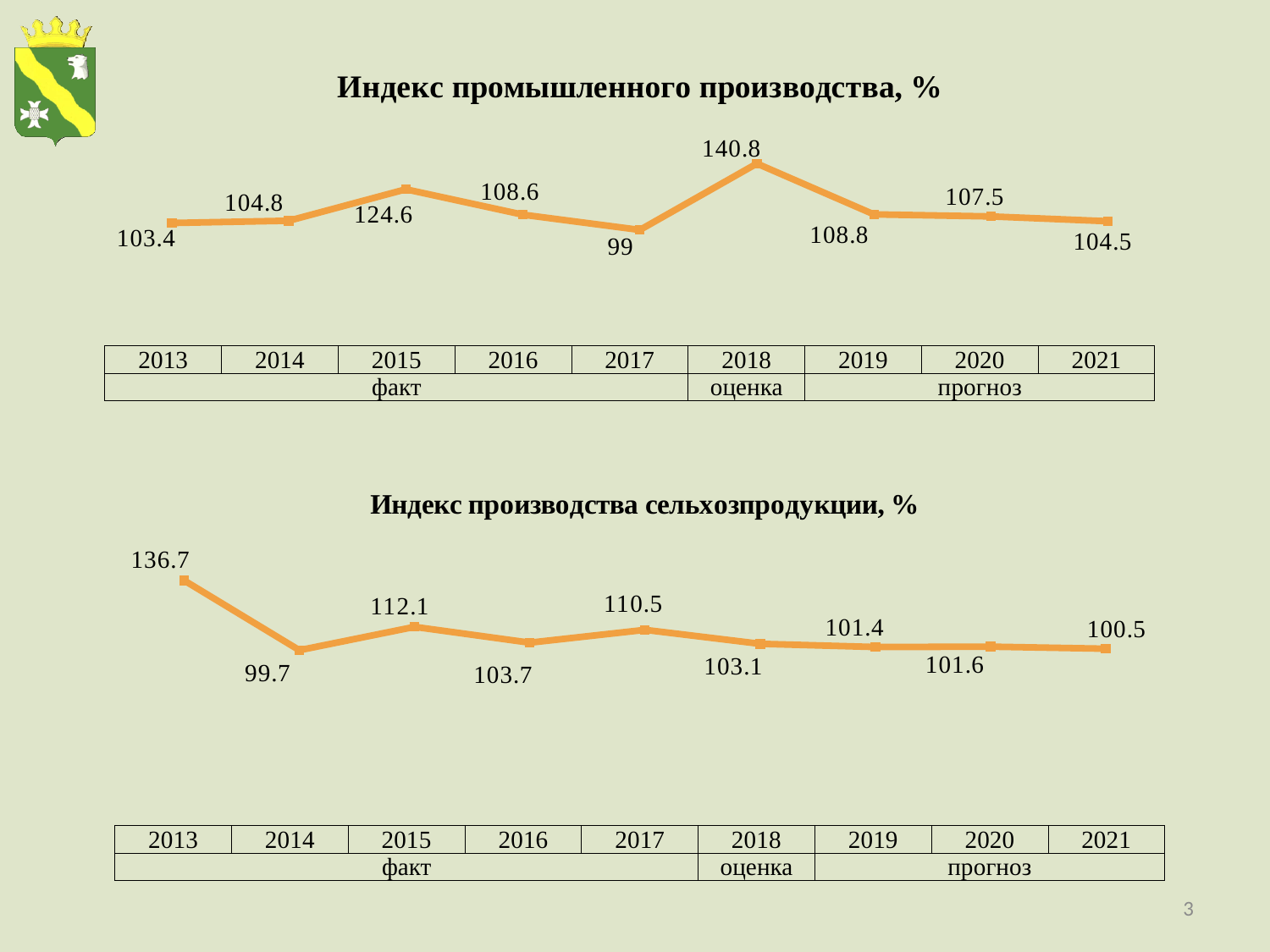
In the chart 'Индекс промышленного производства, %', which year has the lowest value? 2017 What type of chart is the bottom chart 'Индекс производства сельхозпродукции, %'? line chart In the chart 'Индекс производства сельхозпродукции, %', which year has the lowest value? 2014 In the chart 'Индекс производства сельхозпродукции, %', what is the value for 2021? 100.5 In the chart 'Индекс промышленного производства, %', what is the value for 2018? 140.8 In the chart 'Индекс промышленного производства, %', what is the difference between the values for 2015 and 2014? 19.8 In the chart 'Индекс промышленного производства, %', how many data points are plotted? 9 In the chart 'Индекс промышленного производства, %', what is the value for 2017? 99 In the chart 'Индекс промышленного производства, %', which year has the highest value? 2018 In the chart 'Индекс производства сельхозпродукции, %', what is the value for 2013? 136.7 In the chart 'Индекс производства сельхозпродукции, %', what is the difference between the values for 2013 and 2014? 37 In the chart 'Индекс производства сельхозпродукции, %', which is larger, the value for 2015 or the value for 2017? 2015